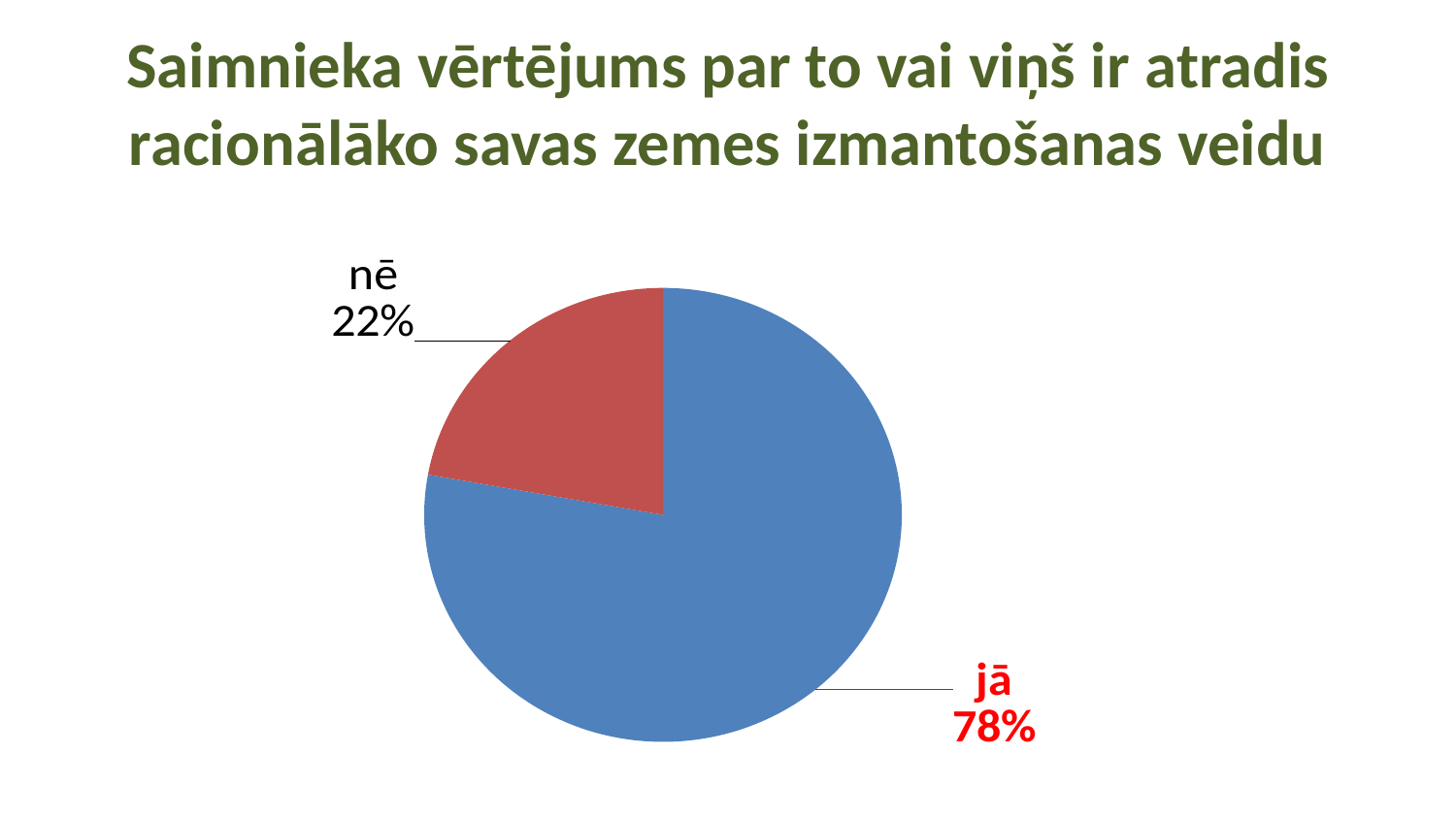
What colour is the "nē" slice? red What kind of chart is shown on the slide? pie chart What share of the pie does the "jā" slice represent? 78% Which is larger, the "jā" slice or the "nē" slice? jā What is the difference in percentage points between the "jā" and "nē" slices? 56 Which slice of the pie is the smallest? nē What colour is the "jā" slice? blue How many slices does the pie chart have? 2 What share of the pie does the "nē" slice represent? 22% Which slice of the pie is the largest? jā